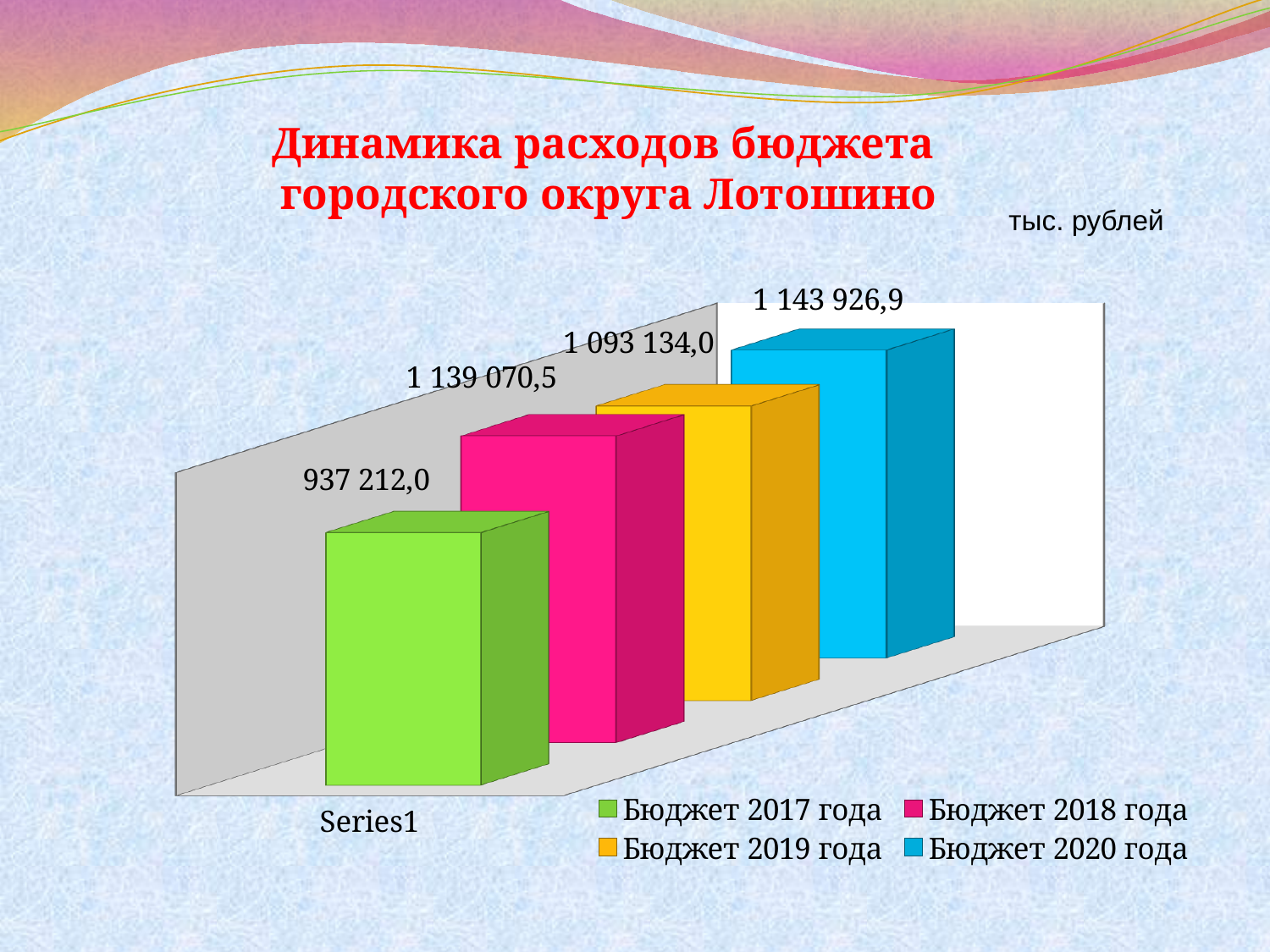
What is the value for Бюджет 2020 года? 1 143 926,9 What is the value for Бюджет 2019 года? 1 093 134,0 Which is larger, the value for Бюджет 2018 года or Бюджет 2019 года? Бюджет 2018 года What kind of chart is shown on the slide? Bar chart How many series does the legend list? 4 What is the value for Бюджет 2018 года? 1 139 070,5 What is the value for Бюджет 2017 года? 937 212,0 What is the difference between the values for Бюджет 2020 года and Бюджет 2017 года? 206 714,9 What unit is stated for the values on the chart? тыс. рублей Which budget year has the highest value? Бюджет 2020 года What is the difference between the values for Бюджет 2018 года and Бюджет 2019 года? 45 936,5 Which budget year has the lowest value? Бюджет 2017 года